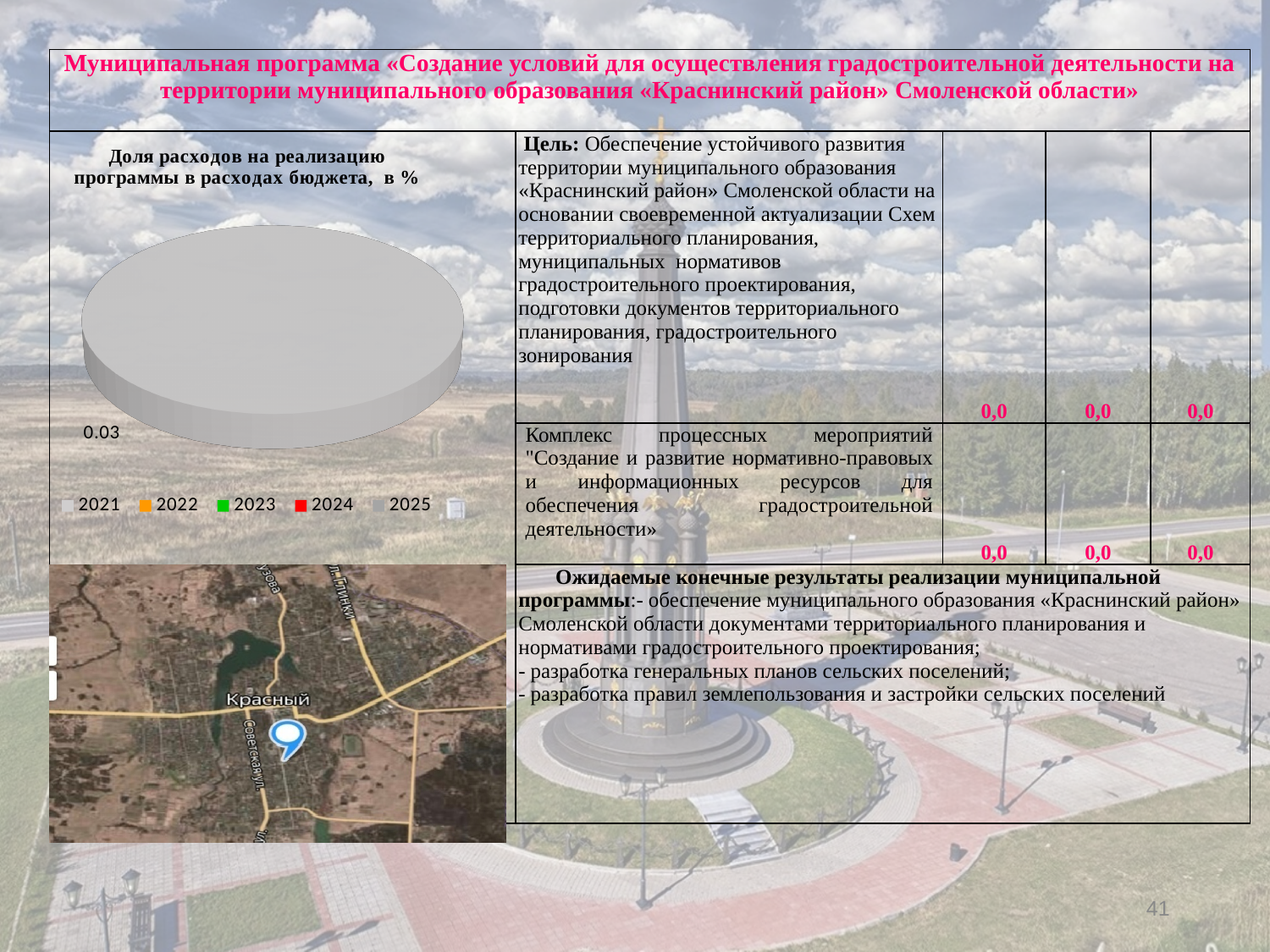
What is the only data label printed on the pie chart? 0.03 What is the title of the pie chart? Доля расходов на реализацию программы в расходах бюджета, в % What kind of chart is shown on the left of the slide under the heading "Доля расходов на реализацию программы в расходах бюджета, в %"? pie chart What is the last year listed in the pie chart legend? 2025 Which year in the pie chart legend is shown in green? 2023 How many years does the legend of the pie chart list? 5 What is the first year listed in the pie chart legend? 2021